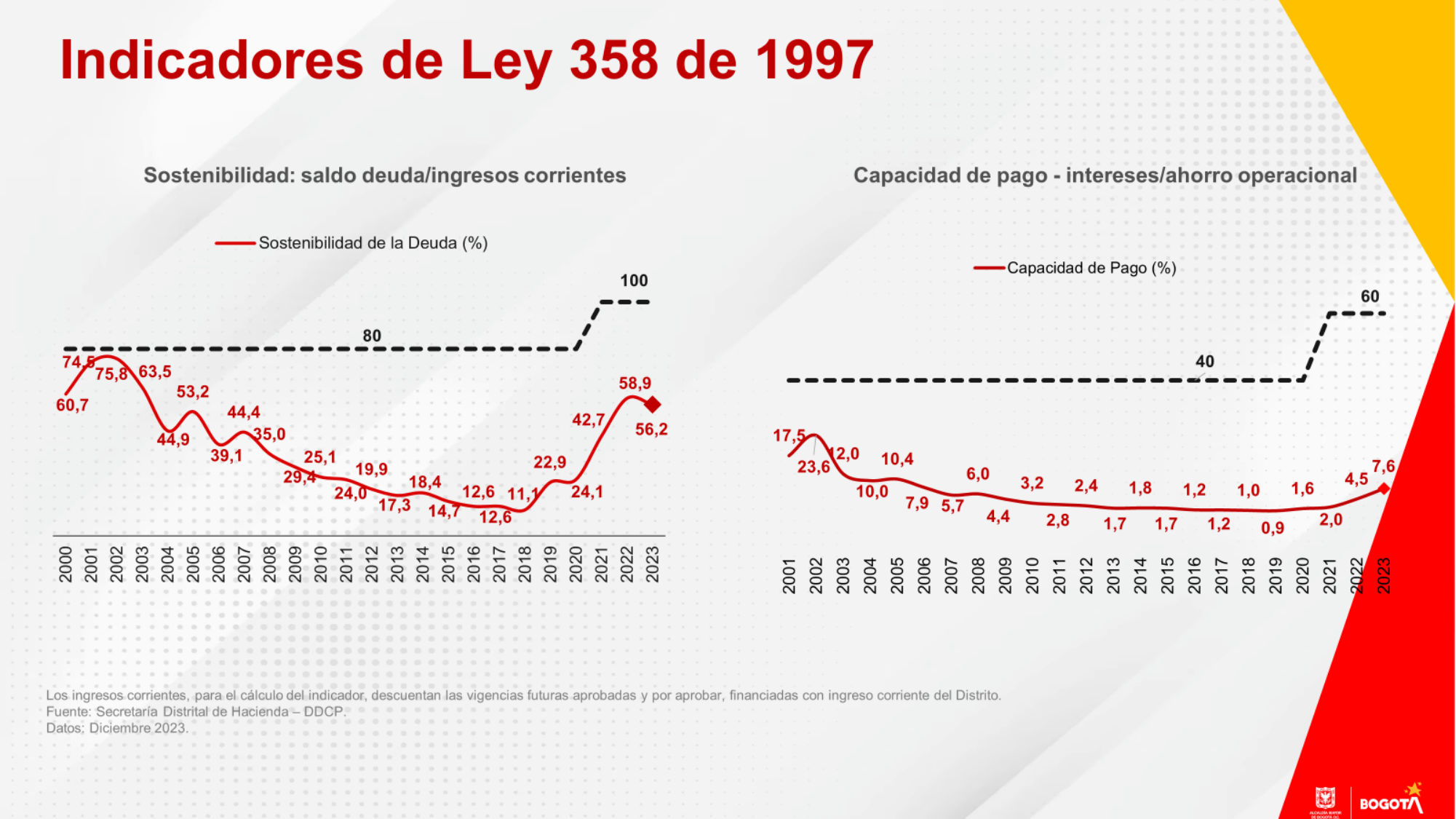
In the 'Sostenibilidad: saldo deuda/ingresos corrientes' chart, what is the difference between the values for 2022 and 2023? 2,7 In the 'Capacidad de pago - intereses/ahorro operacional' chart, which is larger, the value for 2004 or the value for 2005? 2005 In the 'Sostenibilidad: saldo deuda/ingresos corrientes' chart, which year has the highest value? 2002 What kind of chart is the 'Capacidad de pago - intereses/ahorro operacional' chart? line chart In the 'Sostenibilidad: saldo deuda/ingresos corrientes' chart, which year has the lowest value? 2018 In the 'Sostenibilidad: saldo deuda/ingresos corrientes' chart, how many years are plotted on the x axis? 24 In the 'Sostenibilidad: saldo deuda/ingresos corrientes' chart, do the values rise or fall from 2018 to 2022? rise In the 'Capacidad de pago - intereses/ahorro operacional' chart, which year has the highest value? 2002 In the 'Capacidad de pago - intereses/ahorro operacional' chart, which year has the lowest value? 2019 In the 'Capacidad de pago - intereses/ahorro operacional' chart, what is the value for 2023? 7,6 In the 'Capacidad de pago - intereses/ahorro operacional' chart, what series name does the legend show? Capacidad de Pago (%) In the 'Sostenibilidad: saldo deuda/ingresos corrientes' chart, what is the value for 2023? 56,2